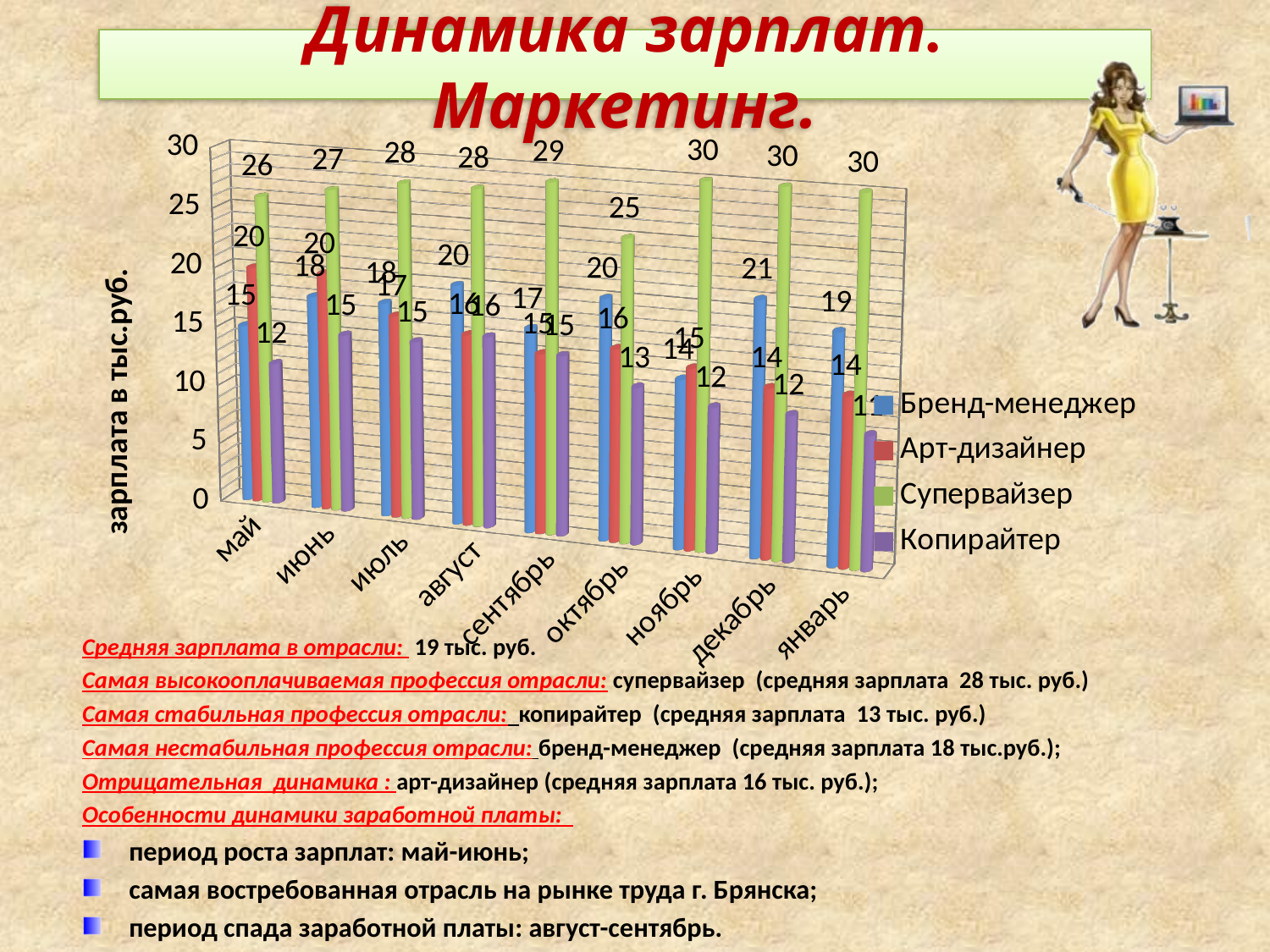
How many months are shown on the x axis? 9 In декабрь, which is larger: Бренд-менеджер or Арт-дизайнер? Бренд-менеджер In which month is the value for Супервайзер the lowest? октябрь What is the value for Супервайзер in май? 26 Does the value for Арт-дизайнер rise or fall from май to январь? fall What is the value for Бренд-менеджер in декабрь? 21 How many series does the legend list? 4 What is the difference between Супервайзер and Копирайтер in май? 14 What kind of chart is shown on the slide? bar chart In which month is the value for Копирайтер the lowest? январь Is the value for Супервайзер in ноябрь greater or less than 25? greater What is the value for Арт-дизайнер in сентябрь? 15